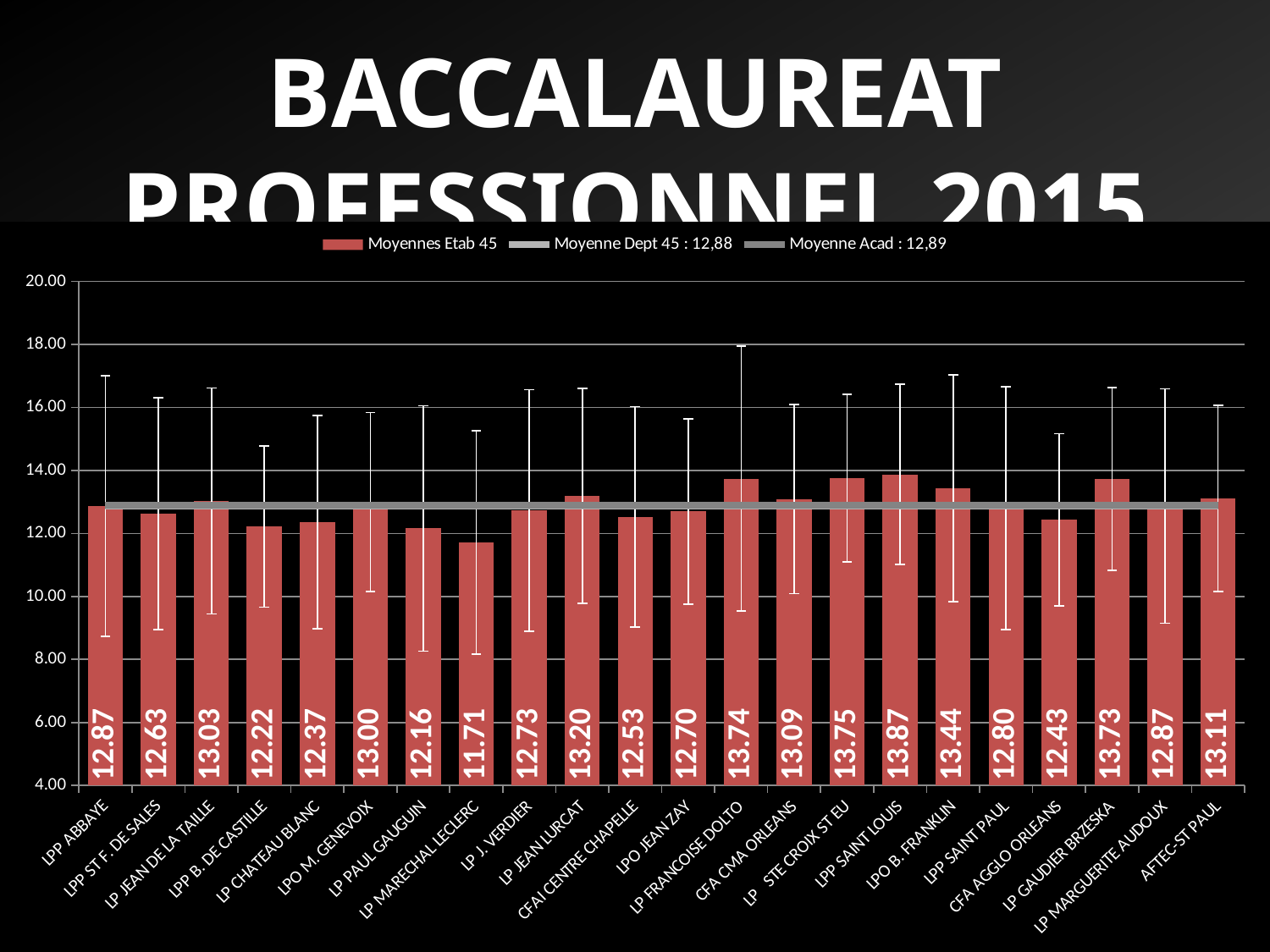
Which establishment has the lowest value? LP MARECHAL LECLERC What is the difference between the values for LPP SAINT LOUIS and LP MARECHAL LECLERC? 2.16 What is the difference between the values for LP JEAN LURCAT and LPP B. DE CASTILLE? 0.98 Which is larger, the value for LP FRANCOISE DOLTO or the value for LP PAUL GAUGUIN? LP FRANCOISE DOLTO What is the value for LPP SAINT LOUIS? 13.87 What value does the legend give for Moyenne Dept 45? 12,88 Which establishment has the highest value? LPP SAINT LOUIS What kind of chart is this? bar chart How many establishments are shown on the x axis? 22 How many entries does the legend list? 3 What is the value for CFA CMA ORLEANS? 13.09 What is the value for LP MARECHAL LECLERC? 11.71